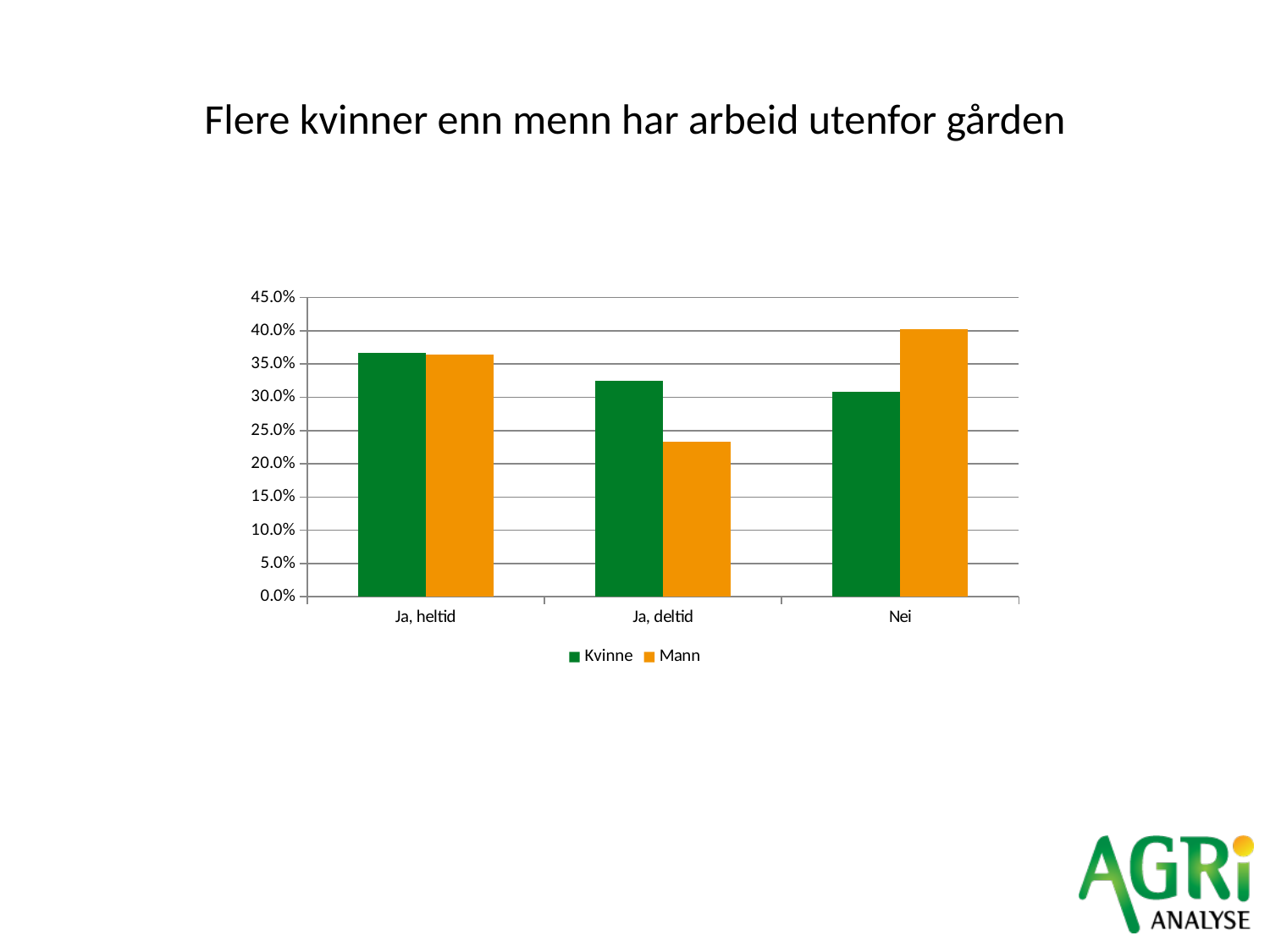
Which colour represents the Mann series? Orange In the Ja, deltid category, which series has the larger value, Kvinne or Mann? Kvinne How many series does the legend list? 2 What is the title of the slide? Flere kvinner enn menn har arbeid utenfor gården For which category is the Mann value lowest? Ja, deltid For which category is the Mann value highest? Nei Is the Mann value for Nei greater or less than 35.0%? greater How many categories are shown on the x axis? 3 Is the Mann value for Ja, deltid greater or less than 25.0%? less For which category is the Kvinne value highest? Ja, heltid What kind of chart is shown on the slide? Bar chart In the Nei category, which series has the larger value, Kvinne or Mann? Mann